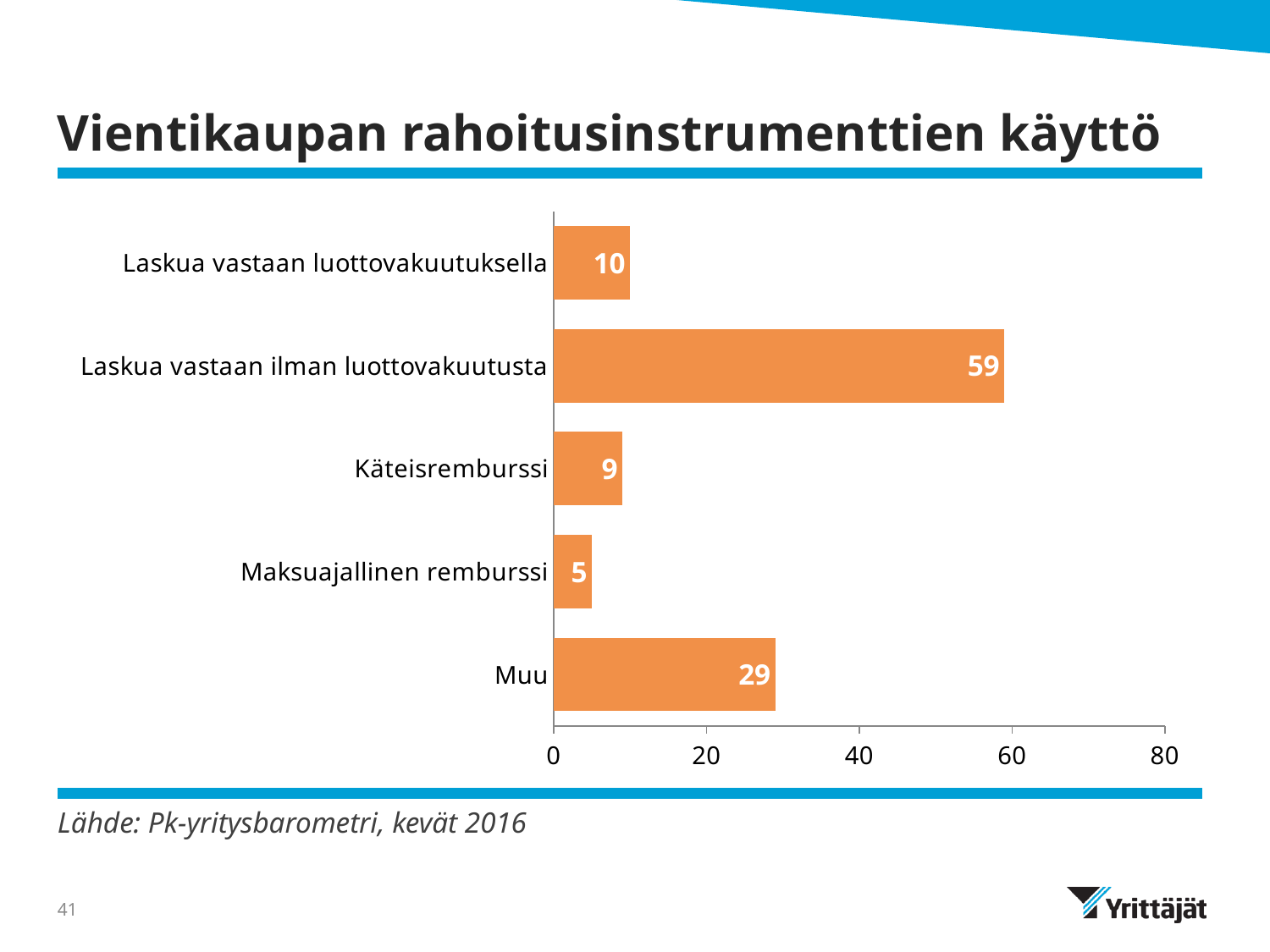
What is the title of the slide? Vientikaupan rahoitusinstrumenttien käyttö What is the value for Muu? 29 What is the value for Käteisremburssi? 9 What is the difference between the values for Laskua vastaan luottovakuutuksella and Käteisremburssi? 1 How many categories are shown in the chart? 5 What is the difference between the values for Laskua vastaan ilman luottovakuutusta and Muu? 30 What kind of chart is shown on the slide? Bar chart What is the value for Maksuajallinen remburssi? 5 Which category has the lowest value? Maksuajallinen remburssi Which category has the highest value? Laskua vastaan ilman luottovakuutusta What is the value for Laskua vastaan ilman luottovakuutusta? 59 Which is larger, the value for Muu or the value for Laskua vastaan luottovakuutuksella? Muu